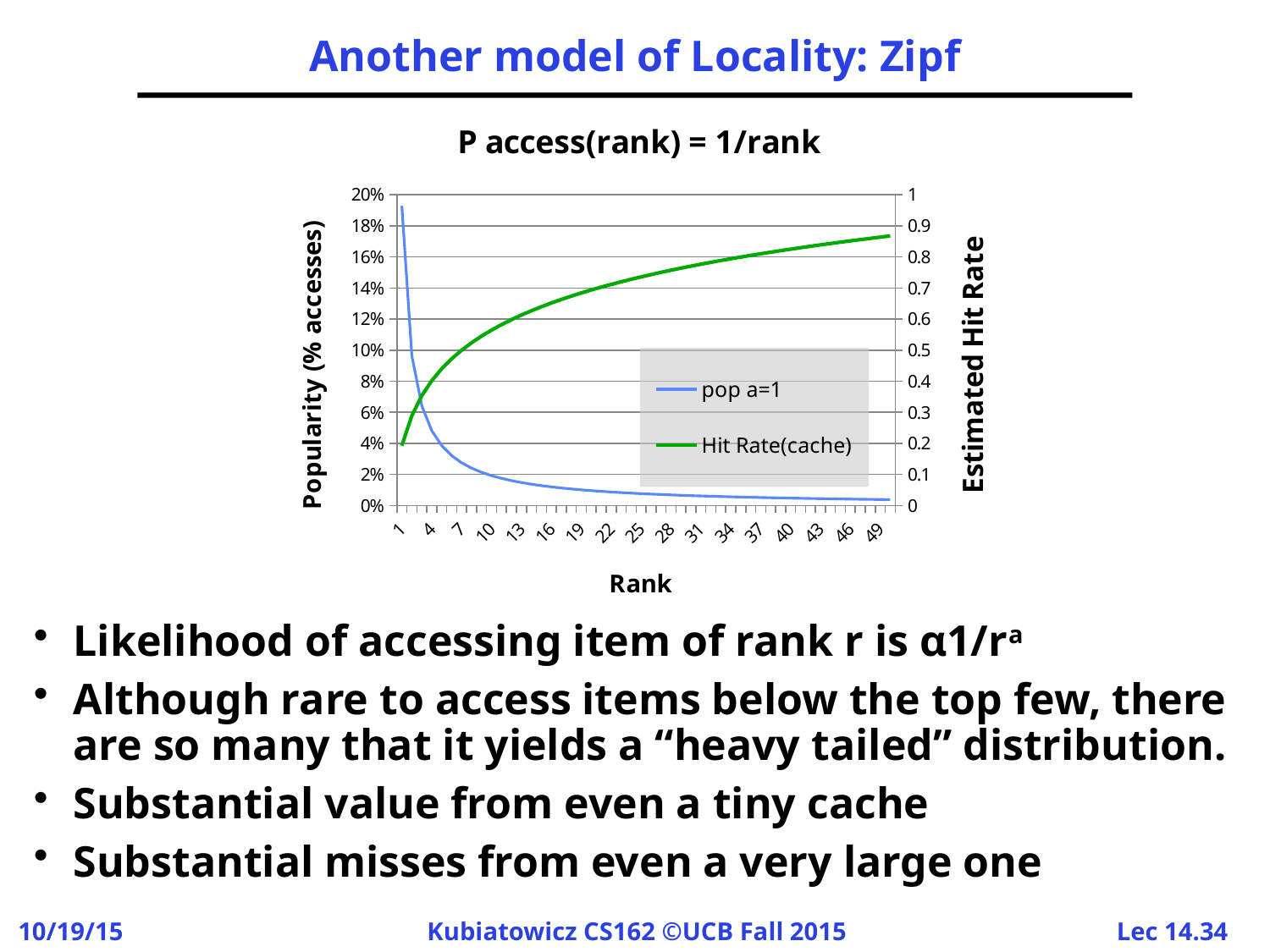
Is the value of 'pop a=1' at rank 10 greater or less than 4%? less Is the value of 'Hit Rate(cache)' at rank 4 greater or less than 0.5? less Is the value of 'pop a=1' at rank 49 greater or less than 2%? less Does the 'pop a=1' series rise or fall as rank increases? fall How many series does the legend list? 2 What is the title of the chart? P access(rank) = 1/rank What is the label of the x axis? Rank What kind of chart is shown on the slide? line chart Does the 'Hit Rate(cache)' series rise or fall as rank increases? rise